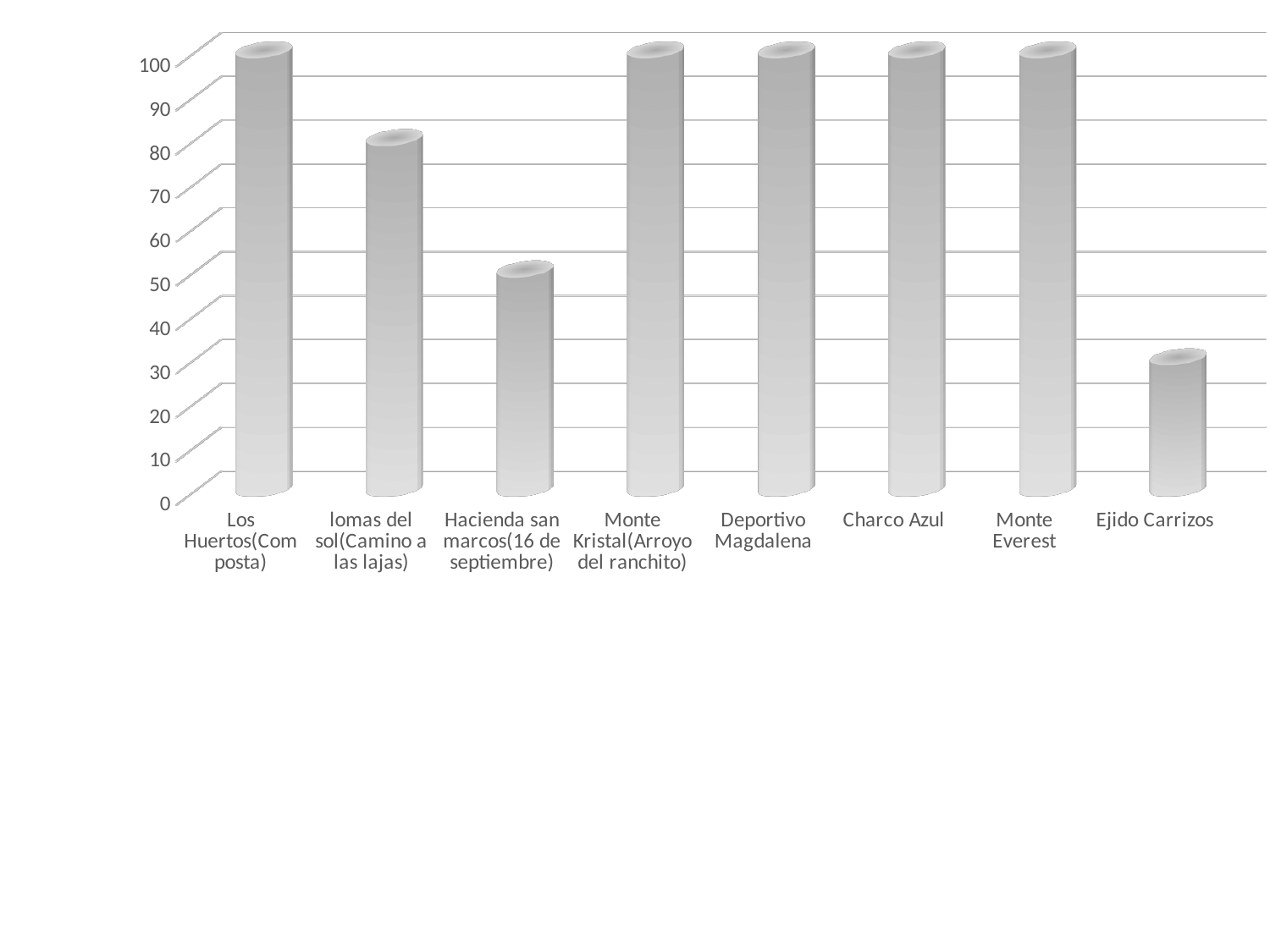
How many categories are shown on the x axis of the chart? 8 Is the value for lomas del sol(Camino a las lajas) greater or less than 90? less Is the value for Ejido Carrizos greater or less than 40? less Which category has the lowest value in the chart? Ejido Carrizos Which is larger, the value for Monte Everest or the value for Ejido Carrizos? Monte Everest What kind of chart is shown on the slide? bar chart Is the value for Hacienda san marcos(16 de septiembre) greater or less than 40? greater Which is larger, the value for lomas del sol(Camino a las lajas) or the value for Hacienda san marcos(16 de septiembre)? lomas del sol(Camino a las lajas) What is the highest value shown on the vertical axis of the chart? 100